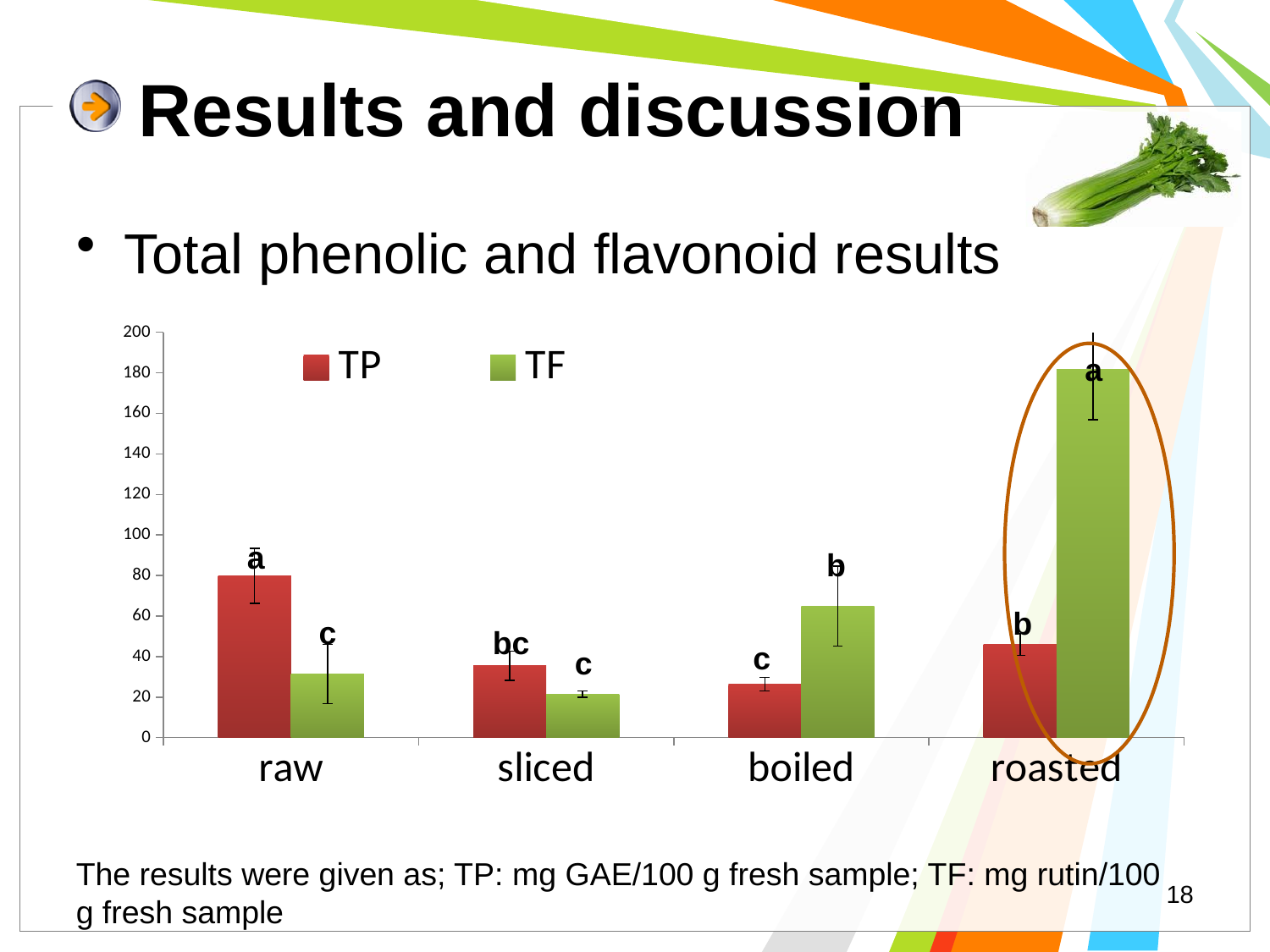
Which category has the lowest TP value? boiled Is the TF value for roasted greater or less than 160? greater What kind of chart is shown on the slide? bar chart Is the TP value for raw greater or less than 100? less Which category has the highest TP value? raw For the boiled sample, which is larger, TP or TF? TF Which category has the highest TF value? roasted Which colour represents the TF series in the chart? green Which category has the lowest TF value? sliced How many categories are shown on the x axis of the chart? 4 How many series does the chart's legend list? 2 For the raw sample, which is larger, TP or TF? TP